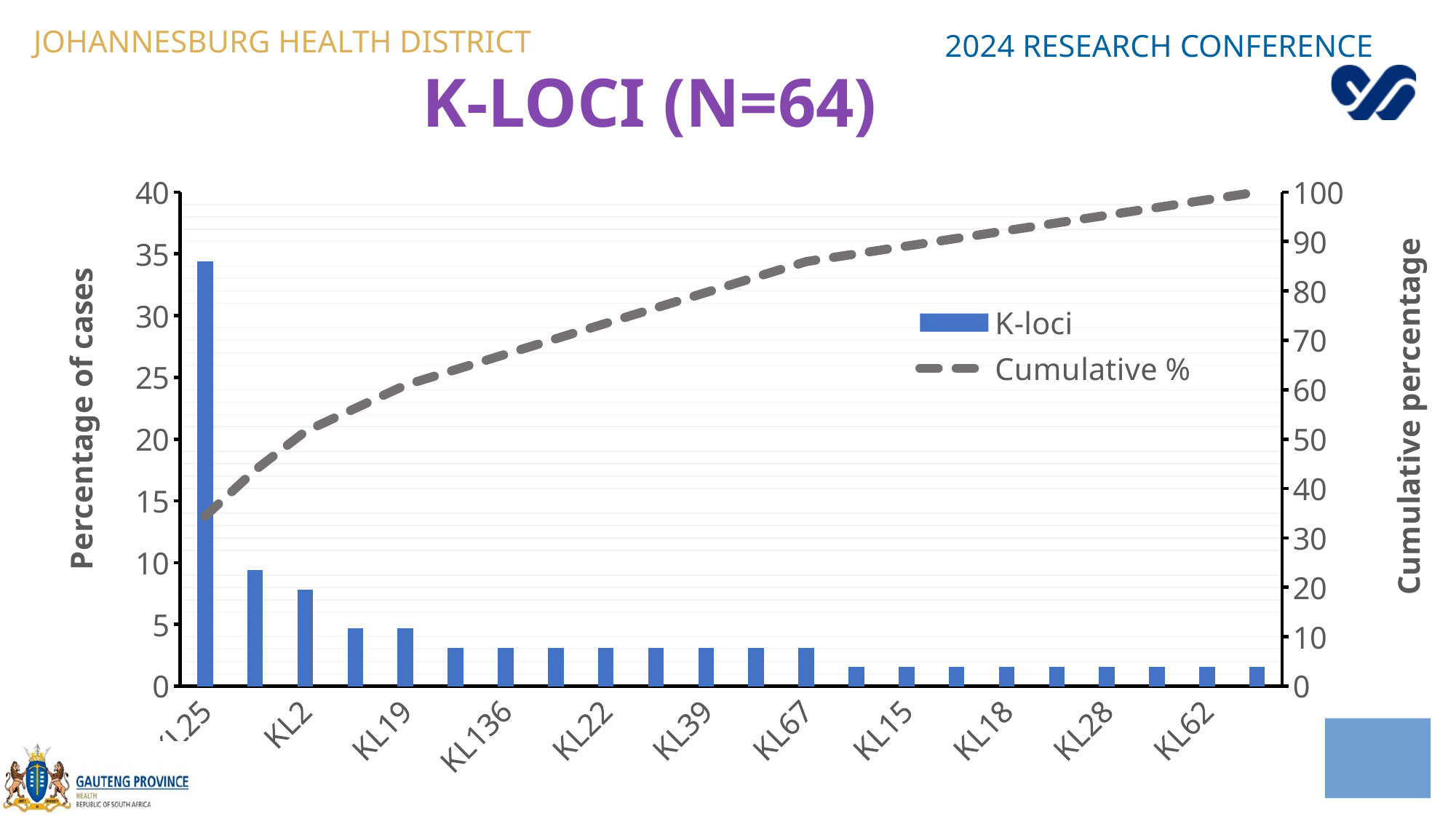
What is the title of the left vertical axis? Percentage of cases Do the K-loci bars rise or fall from left to right along the x axis? fall How many series does the legend list? 2 What kind of chart is shown on the slide? Bar chart with a cumulative line What are the two entries in the chart legend? K-loci and Cumulative % Is the percentage of cases for KL15 greater or less than 5? less Which has a higher percentage of cases, KL19 or KL15? KL19 Is the percentage of cases for KL2 greater or less than 10? less Which has a higher percentage of cases, KL2 or KL19? KL2 Is the cumulative percentage at KL67 greater or less than 80? greater